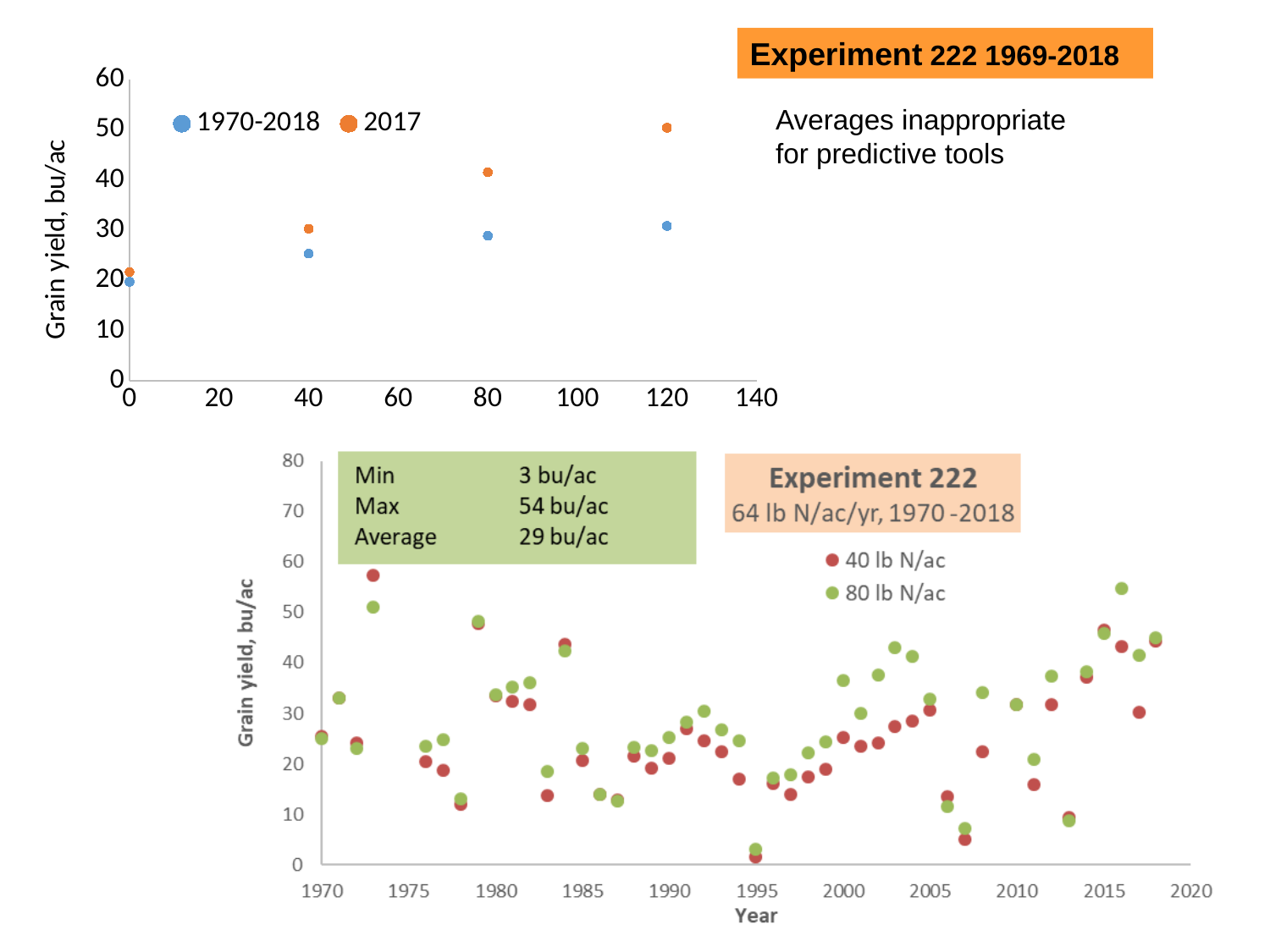
In the top chart, do the 2017 values rise or fall as the x-axis value increases from 0 to 120? rise In the top chart, what are the two legend entries? 1970-2018 and 2017 In the bottom chart, is the 40 lb N/ac value for 1995 greater or less than 10? less In the top chart, is the 1970-2018 value at x = 120 greater or less than 40? less In the bottom chart, how many series does the legend list? 2 In the bottom chart, what average grain yield is stated in the summary box? 29 bu/ac In the top chart, how many points are plotted for the 2017 series? 4 In the bottom chart, what maximum grain yield is stated in the summary box? 54 bu/ac In the top chart, at x = 120, which series has the higher grain yield, 1970-2018 or 2017? 2017 What kind of chart is the bottom chart (Experiment 222, 64 lb N/ac/yr)? scatter chart In the top chart, is the 2017 value at x = 120 greater or less than 40? greater In the top chart, how many series does the legend list? 2